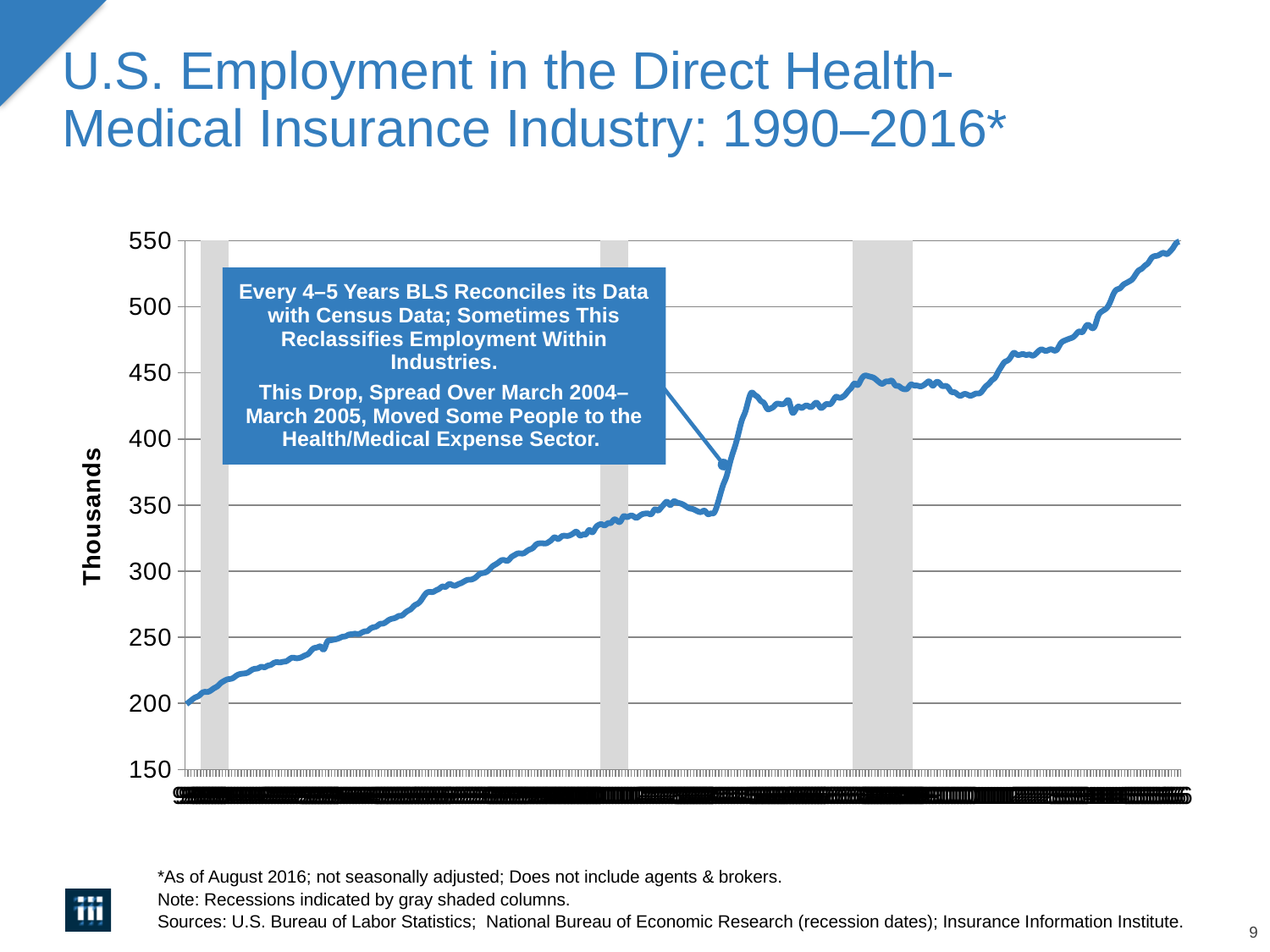
What kind of chart is shown on the slide? line chart What is the highest value shown on the vertical axis of the chart? 550 What is the title of the chart on the slide? U.S. Employment in the Direct Health-Medical Insurance Industry: 1990–2016* Which is larger, the value at the start of the line or the value at the end of the line? the value at the end What is the label on the vertical axis of the chart? Thousands Is the value at the far right (end) of the line greater or less than 500? greater Is the value at the far left (start) of the line greater or less than 250? less Overall, do the values rise or fall from left to right along the x axis? rise Is the value at the far left (start) of the line greater or less than 150? greater